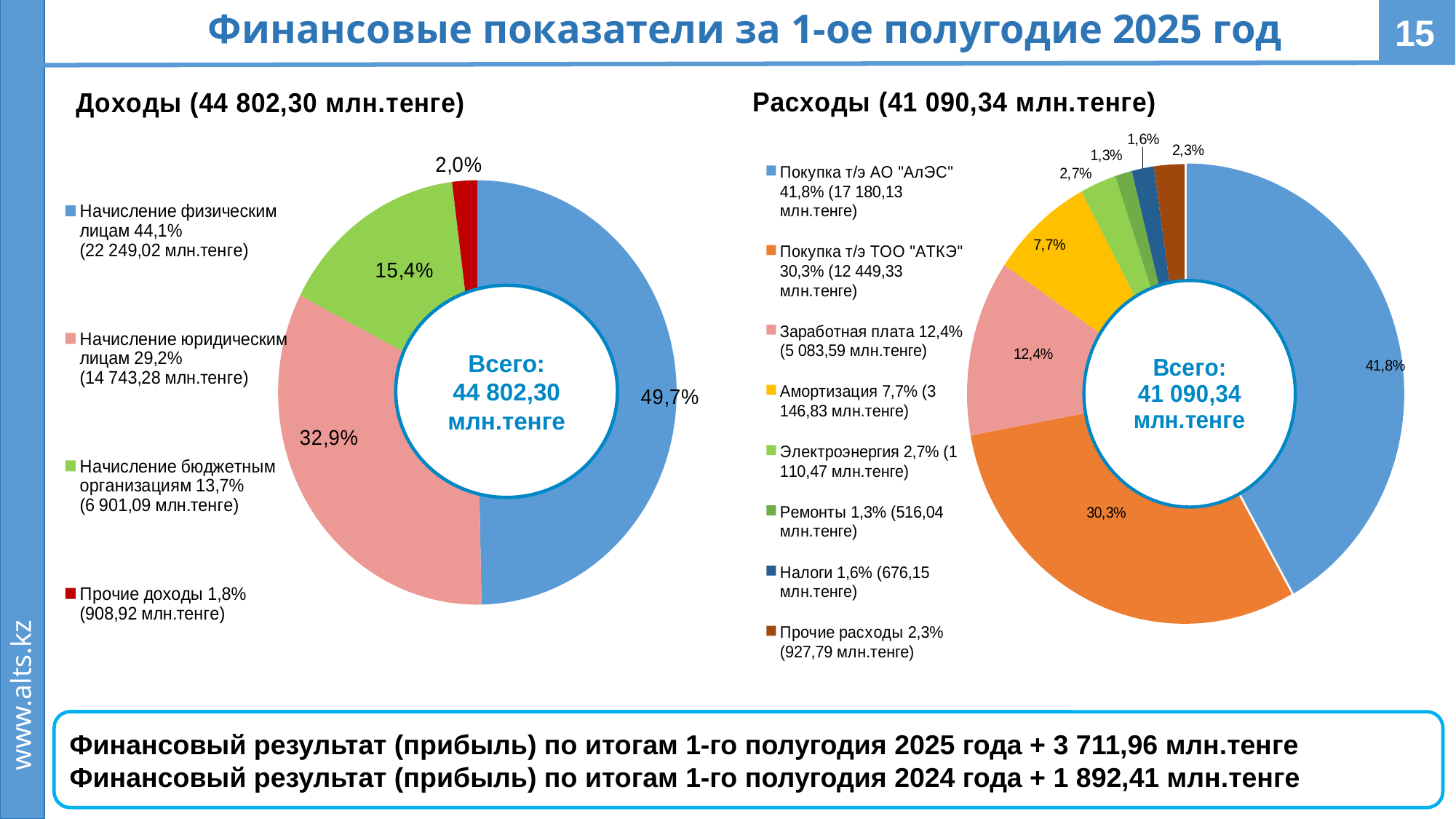
In the Доходы chart, what amount in млн.тенге is shown for Прочие доходы? 908,92 млн.тенге In the Расходы chart, what amount in млн.тенге is shown for Заработная плата? 5 083,59 млн.тенге In the Доходы chart, what amount in млн.тенге is shown for Начисление физическим лицам? 22 249,02 млн.тенге In the Расходы chart, what share is shown for Покупка т/э ТОО "АТКЭ"? 30,3% In the Расходы chart, which category has the smallest share? Ремонты In the Расходы chart, what is the difference in percentage points between Покупка т/э АО "АлЭС" (41,8%) and Покупка т/э ТОО "АТКЭ" (30,3%)? 11,5 How many categories does the legend of the Расходы chart list? 8 In the Доходы chart, which category has the largest share? Начисление физическим лицам In the Расходы chart, which is larger: Амортизация or Электроэнергия? Амортизация What kind of chart is used for Доходы (44 802,30 млн.тенге)? Pie (donut) chart In the Доходы chart, which category has the smallest share? Прочие доходы How many categories does the legend of the Доходы chart list? 4